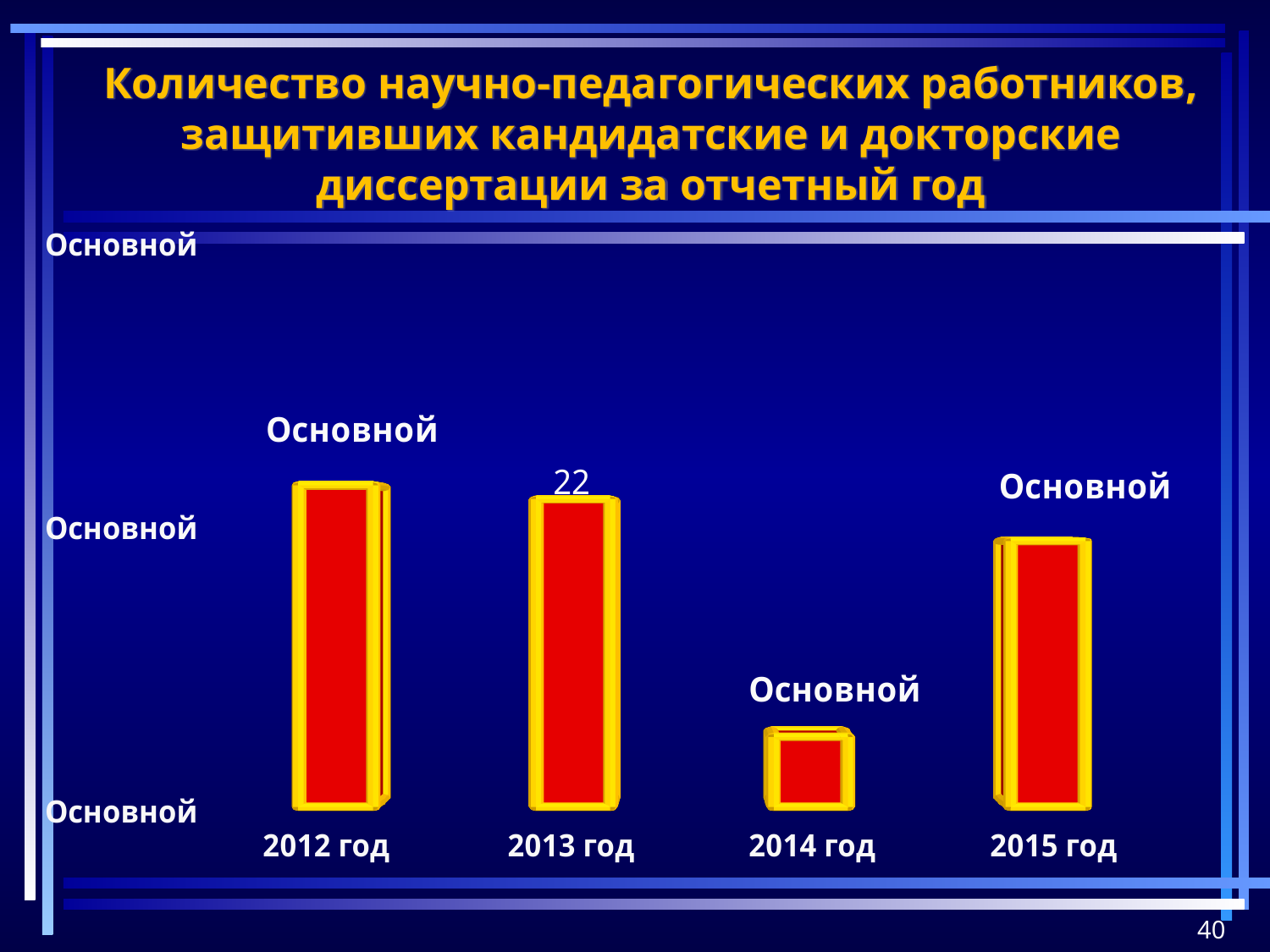
Do the bar values rise or fall from 2014 год to 2015 год? rise Which bar is taller, 2013 год or 2014 год? 2013 год Do the bar values rise or fall from 2013 год to 2014 год? fall What is the first year shown on the x axis of the chart? 2012 год Which bar is taller, 2012 год or 2015 год? 2012 год Which year has the lowest bar in the chart? 2014 год What value is printed above the bar for 2013 год? 22 Which bar is taller, 2015 год or 2014 год? 2015 год Which year has the highest bar in the chart? 2012 год How many categories (years) are shown on the x axis of the chart? 4 What type of chart is shown on the slide? bar chart